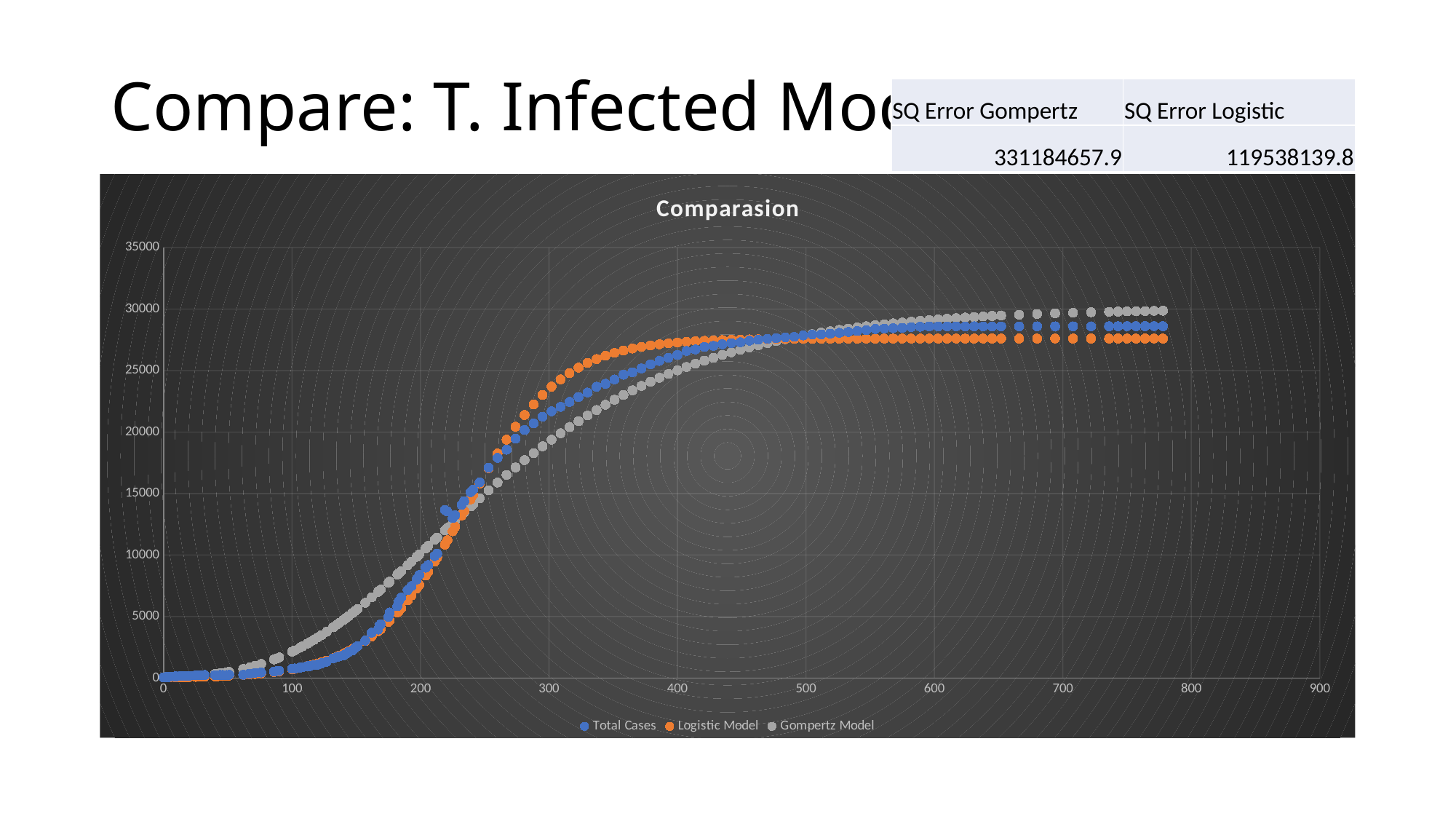
Is the value of the Gompertz Model at x = 100 greater or less than 5000? less Which series reaches the highest value at the right end of the chart (around x = 750)? Gompertz Model What kind of chart is shown on the slide? scatter chart Do the values of the Total Cases series rise or fall as the x axis increases? rise At x = 150, which series has the higher value, the Gompertz Model or the Logistic Model? Gompertz Model Is the value of the Logistic Model at x = 400 greater or less than 25000? greater Is the value of Total Cases at x = 100 greater or less than 5000? less At x = 300, which series has the higher value, the Logistic Model or the Gompertz Model? Logistic Model What is the title of the chart? Comparasion How many series does the legend of the chart list? 3 Which series is shown in orange in the chart? Logistic Model